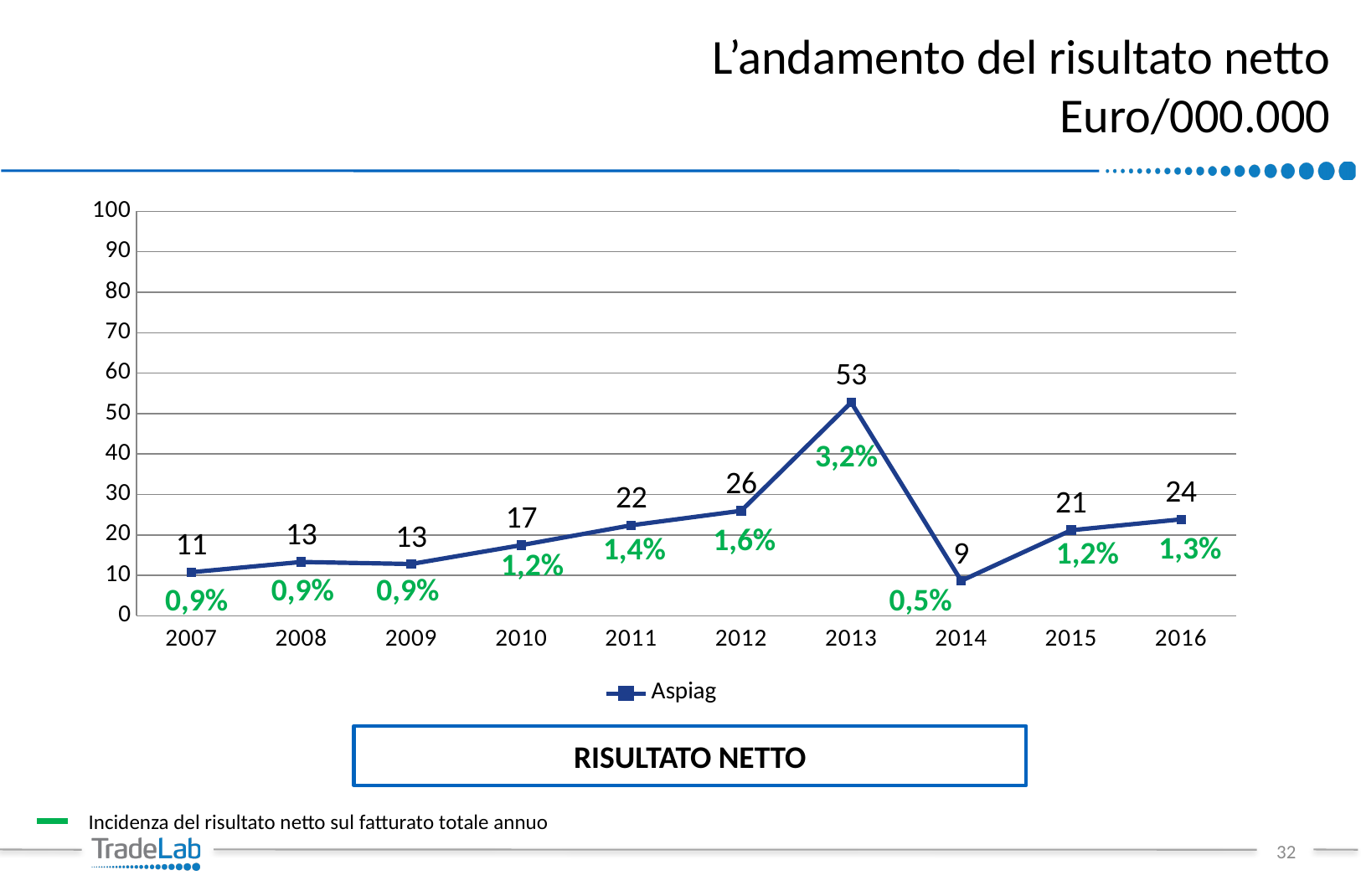
What kind of chart is shown on the slide? line chart What percentage incidence on annual turnover is shown for 2014? 0,5% What is the net result value for Aspiag in 2013? 53 Which year has the highest net result? 2013 What is the difference between the net result in 2013 and in 2014? 44 Which year has the lowest net result? 2014 What is the name of the series shown in the legend? Aspiag Which year has the larger net result, 2012 or 2016? 2012 What is the net result value for Aspiag in 2010? 17 How many series does the legend list? 1 Is the net result for 2013 greater or less than 50? greater How many years are plotted on the x axis? 10